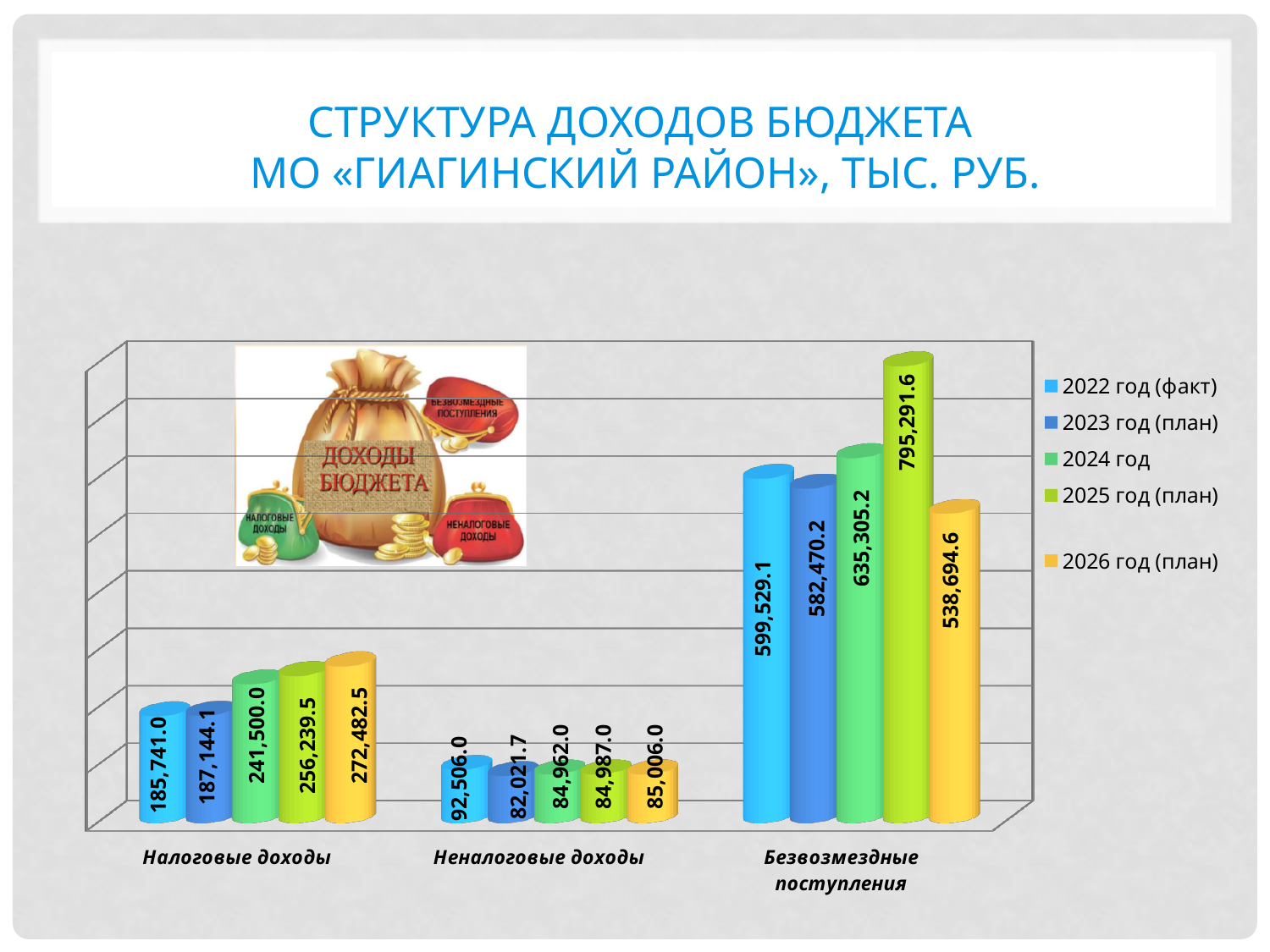
Do the values for Налоговые доходы rise or fall from 2022 год (факт) to 2026 год (план)? Rise What is the difference between the 2025 год (план) and 2026 год (план) values for Безвозмездные поступления? 256,597.0 What is the value for Налоговые доходы in 2022 год (факт)? 185,741.0 Which year has the highest value for Безвозмездные поступления? 2025 год (план) What is the value for Неналоговые доходы in 2026 год (план)? 85,006.0 How many categories are shown on the x axis? 3 Which year has the lowest value for Неналоговые доходы? 2023 год (план) What is the value for Безвозмездные поступления in 2025 год (план)? 795,291.6 What kind of chart is shown on the slide? Bar chart How many series does the legend list? 5 Which is larger for Налоговые доходы: the 2023 год (план) value or the 2024 год value? 2024 год What is the difference between the 2026 год (план) and 2022 год (факт) values for Налоговые доходы? 86,741.5